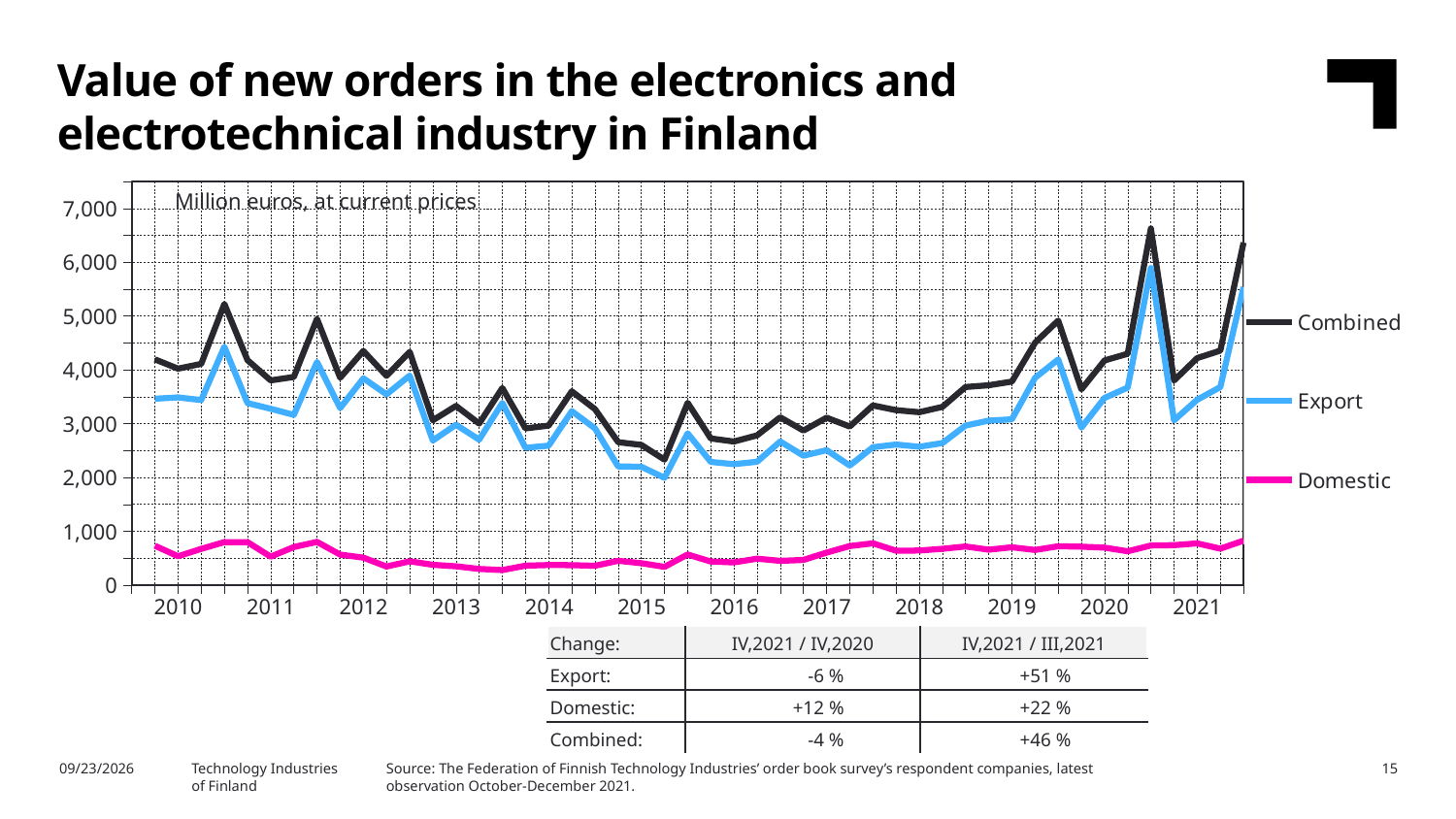
Is the Export value at the end of 2021 greater or less than 5,000? greater Which is larger at the end of 2021, the Combined value or the Export value? Combined Which series has the highest values throughout the whole period? Combined Is the Domestic value at the start of 2010 greater or less than 1,000? less Is the peak Combined value in 2020 greater or less than 6,000? greater Which series has the lowest values throughout the whole period? Domestic Does the Combined series generally rise or fall between 2010 and 2015? fall How many series does the legend list? 3 Which series are listed in the chart legend? Combined, Export, Domestic What type of chart is shown on the slide? Line chart What unit is stated for the values on the chart? Million euros, at current prices